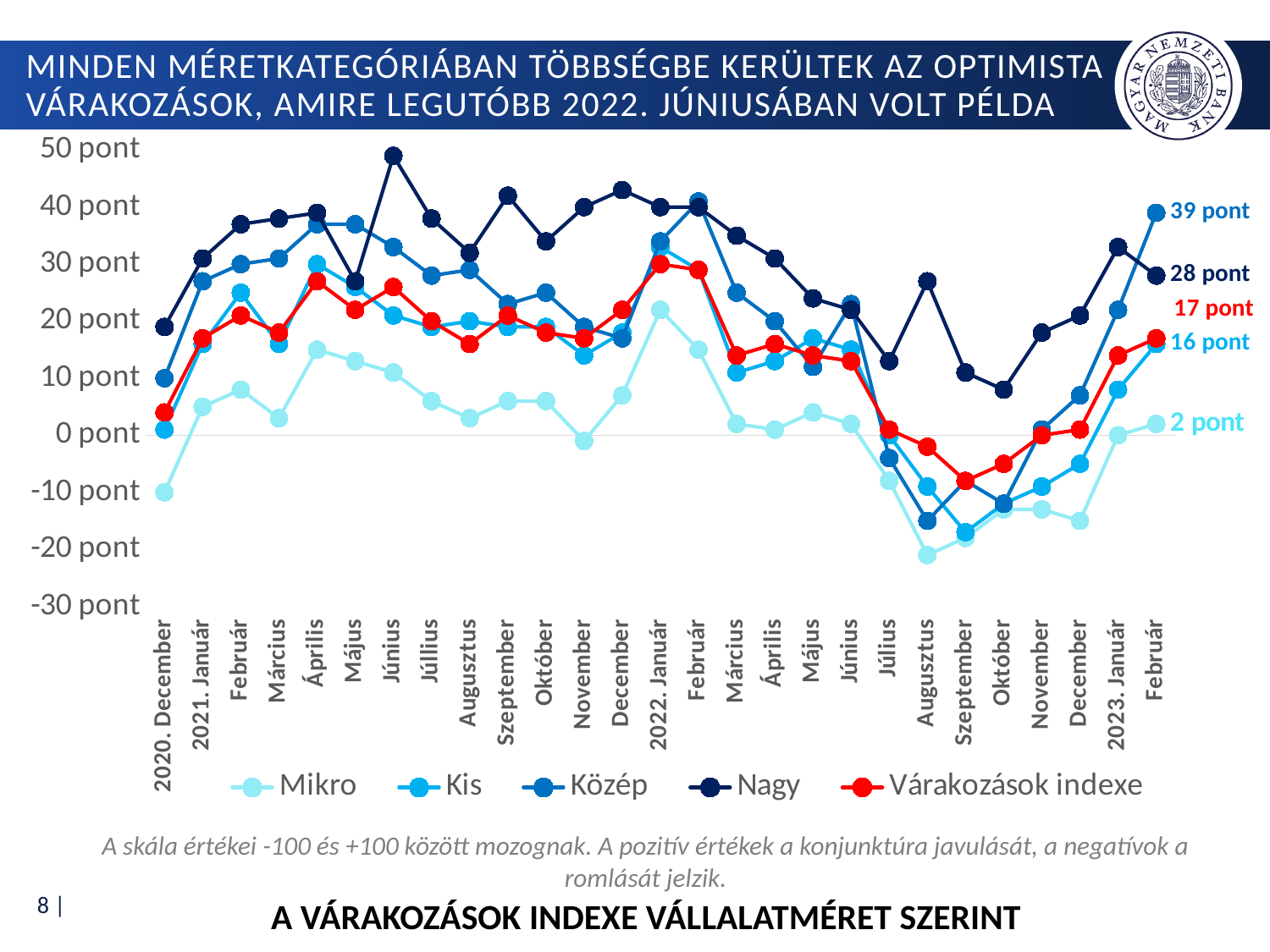
Which series has the lowest value in 2023. Február? Mikro What is the value of the Nagy series in 2023. Február? 28 pont Is the value for the Nagy series in 2021. Június greater or less than 40 pont? greater What type of chart is shown on the slide? line chart What is the value of the Várakozások indexe series in 2023. Február? 17 pont What is the difference between the Közép and Nagy values in 2023. Február? 11 pont How many series does the legend list? 5 What is the value of the Mikro series in 2023. Február? 2 pont What is the title of the chart? A VÁRAKOZÁSOK INDEXE VÁLLALATMÉRET SZERINT Is the value for the Mikro series in 2022. Augusztus greater or less than -10 pont? less What is the value of the Közép series in 2023. Február? 39 pont Which series has the highest value in 2023. Február? Közép